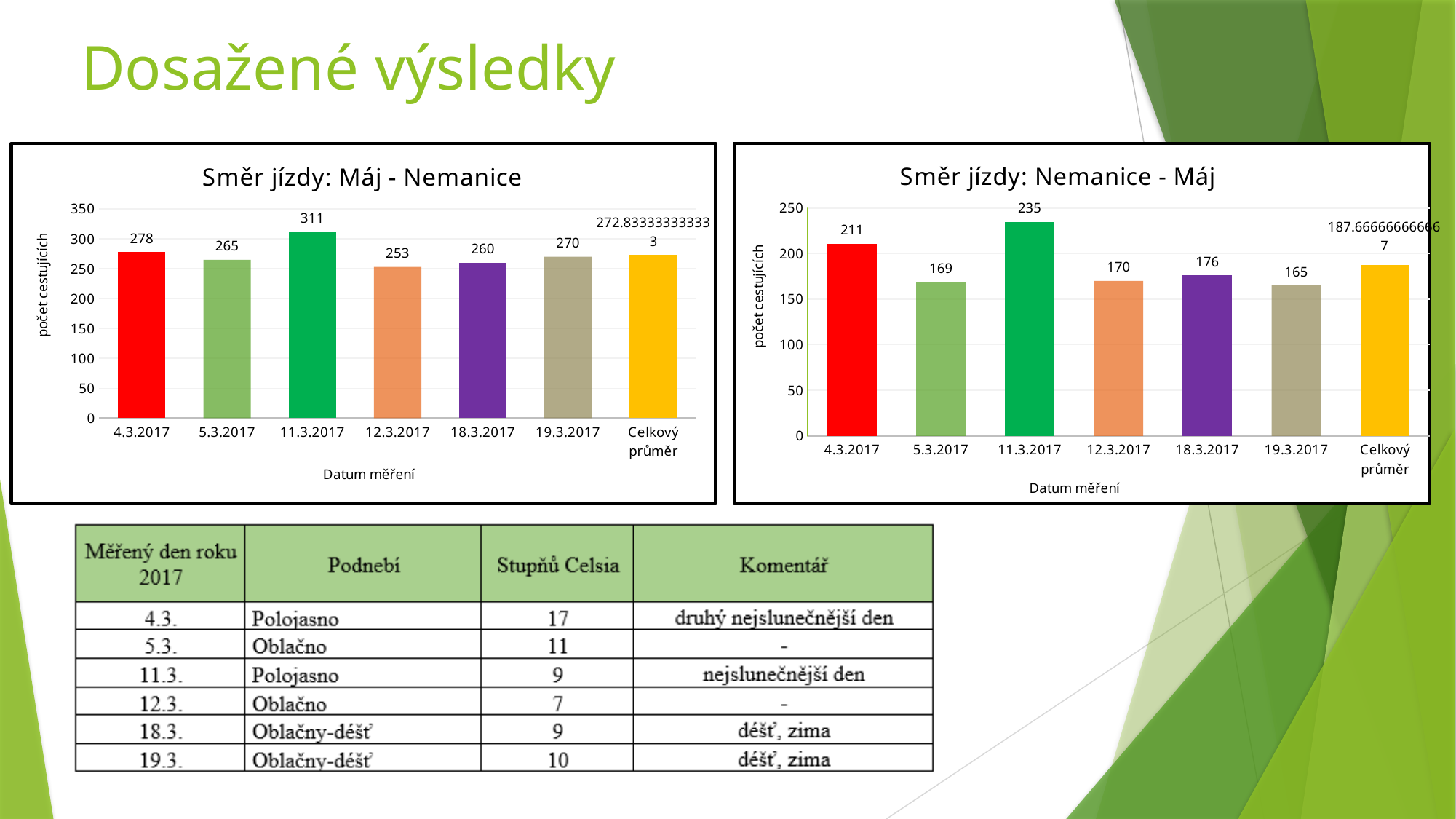
In the chart titled 'Směr jízdy: Máj - Nemanice', what is the value for 4.3.2017? 278 In the chart titled 'Směr jízdy: Máj - Nemanice', what is the difference between the values for 11.3.2017 and 12.3.2017? 58 How many bars are shown in the chart titled 'Směr jízdy: Nemanice - Máj'? 7 In the chart titled 'Směr jízdy: Nemanice - Máj', which is larger, the value for 18.3.2017 or the value for 19.3.2017? 18.3.2017 In the chart titled 'Směr jízdy: Máj - Nemanice', what is the value for 11.3.2017? 311 In the chart titled 'Směr jízdy: Máj - Nemanice', which date has the lowest number of passengers? 12.3.2017 In the chart titled 'Směr jízdy: Nemanice - Máj', what is the difference between the values for 4.3.2017 and 5.3.2017? 42 What is the x-axis title of the chart titled 'Směr jízdy: Nemanice - Máj'? Datum měření What kind of chart is the chart titled 'Směr jízdy: Máj - Nemanice'? bar chart In the chart titled 'Směr jízdy: Nemanice - Máj', which date has the highest number of passengers? 11.3.2017 In the chart titled 'Směr jízdy: Máj - Nemanice', is the value for 'Celkový průměr' greater or less than 250? greater In the chart titled 'Směr jízdy: Nemanice - Máj', what is the value for 19.3.2017? 165